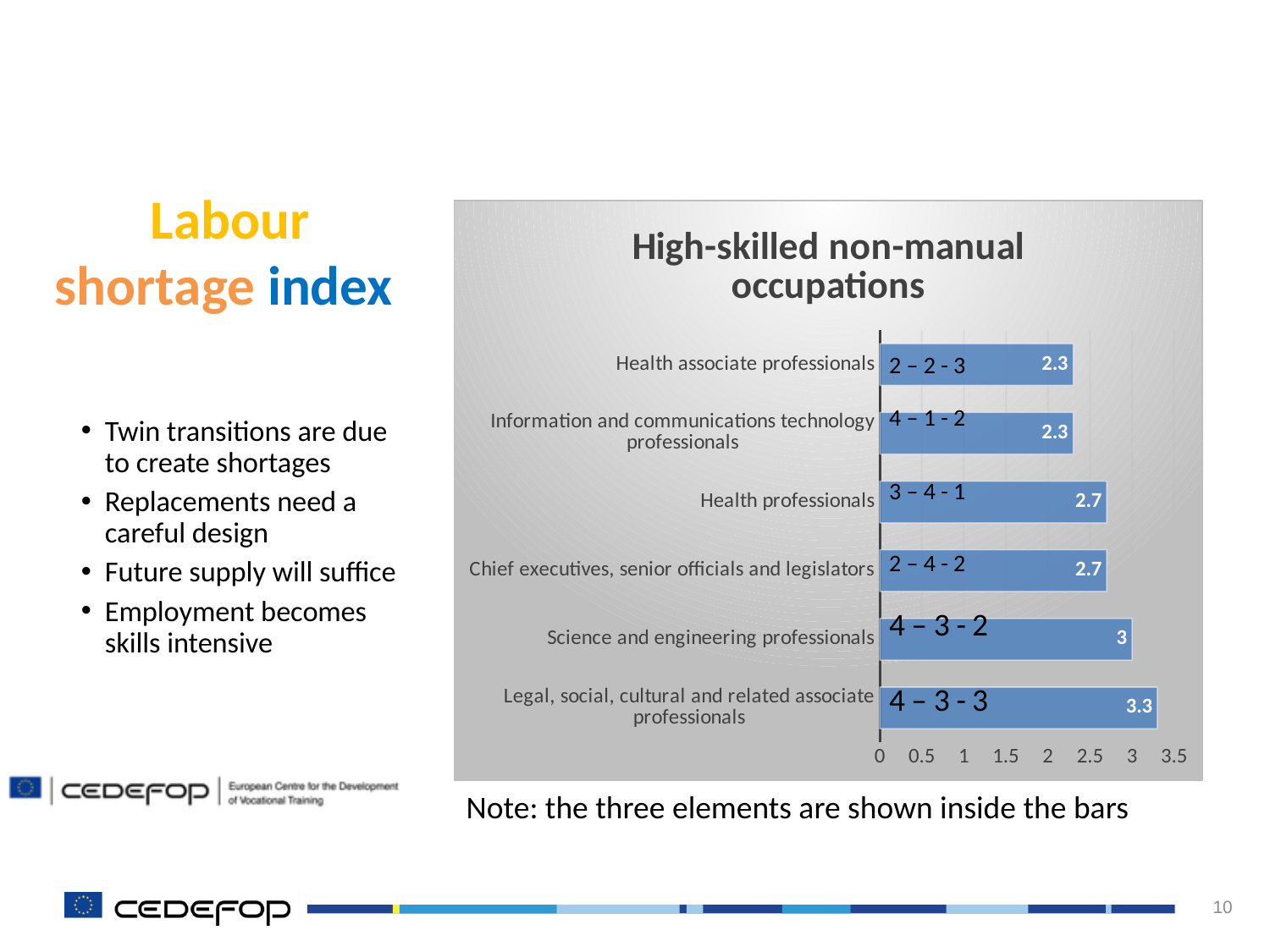
What is the value for Science and engineering professionals? 3 What is the value for Legal, social, cultural and related associate professionals? 3.3 What is the difference between the values for Science and engineering professionals and Chief executives, senior officials and legislators? 0.3 Which is larger, the value for Health professionals or the value for Information and communications technology professionals? Health professionals What kind of chart is shown? Bar chart What is the value for Health associate professionals? 2.3 Which occupation has the highest value? Legal, social, cultural and related associate professionals What is the title of the chart? High-skilled non-manual occupations What is the difference between the values for Legal, social, cultural and related associate professionals and Health associate professionals? 1 Is the value for Science and engineering professionals greater or less than 2.5? greater What is the value for Health professionals? 2.7 How many occupations are shown in the chart? 6